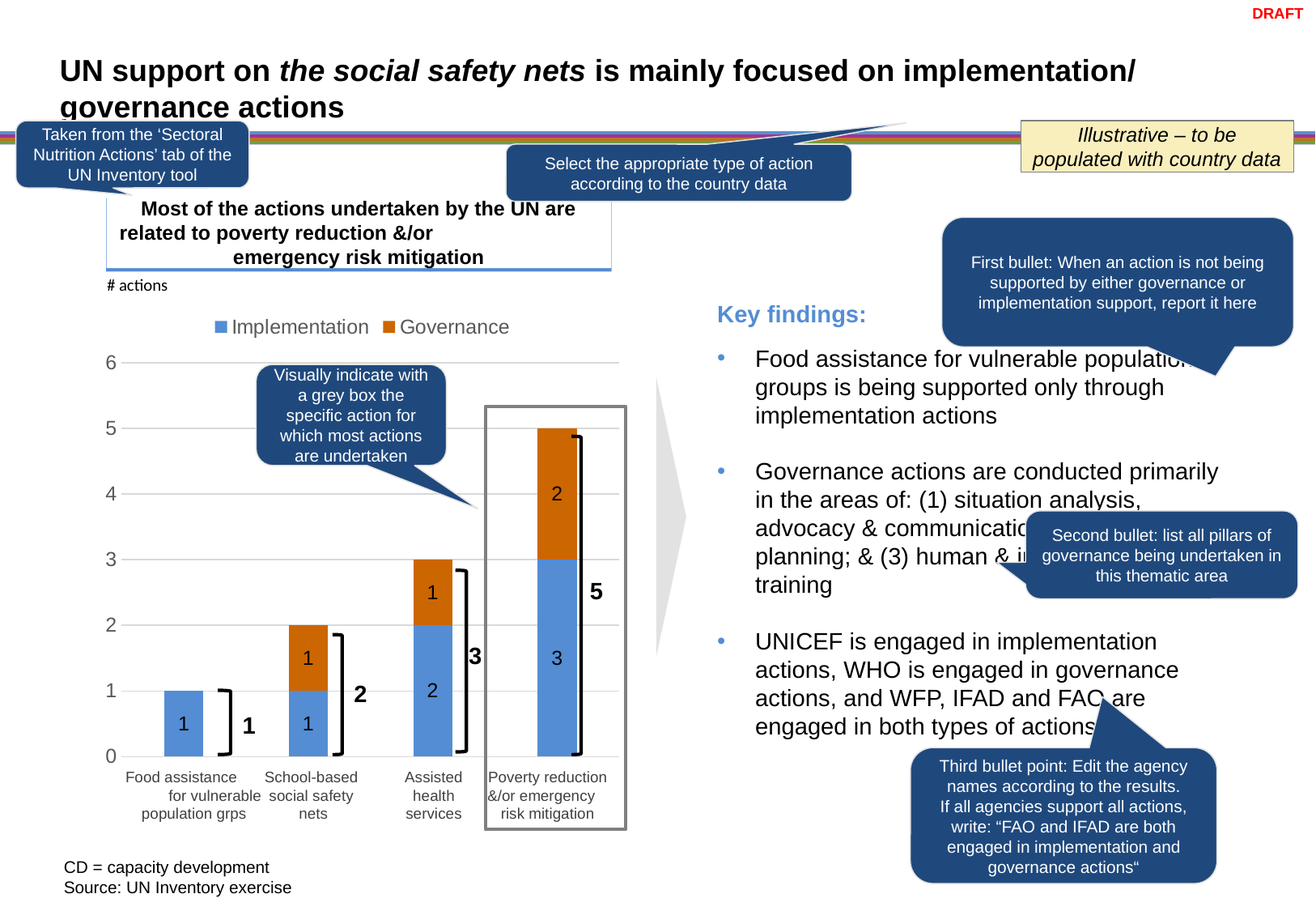
What is the Implementation value for Food assistance for vulnerable population grps? 1 Which category has the highest total number of actions? Poverty reduction &/or emergency risk mitigation What is the total number of actions for the Poverty reduction &/or emergency risk mitigation bar? 5 How many series does the chart legend list? 2 What is the Implementation value for Poverty reduction &/or emergency risk mitigation? 3 How many categories are shown on the x axis of the chart? 4 Which category has the lowest total number of actions? Food assistance for vulnerable population grps What is the total number of actions for the School-based social safety nets bar? 2 What is the difference between the Implementation values for Poverty reduction &/or emergency risk mitigation and Assisted health services? 1 What type of chart is shown on the slide? Stacked bar chart What is the Governance value for Assisted health services? 1 Which series is shown in orange in the chart legend? Governance